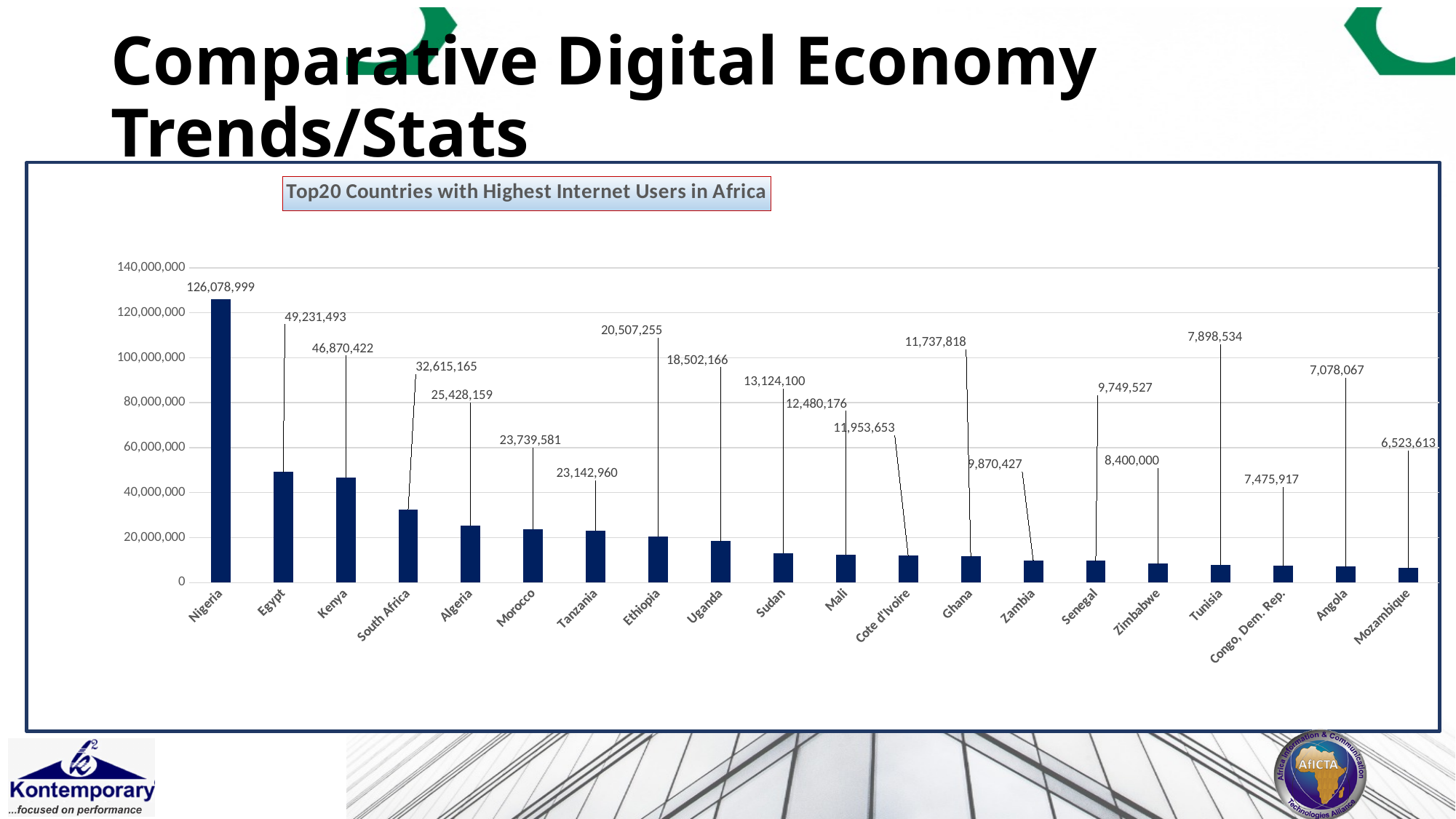
Which country has the highest number of internet users? Nigeria Which country has the lowest number of internet users in the chart? Mozambique How many countries are shown in the chart? 20 What is the value shown for Ghana? 11,737,818 Is the value for Egypt greater or less than 40,000,000? greater Which has more internet users, Morocco or Tanzania? Morocco What is the number of internet users for South Africa? 32,615,165 What kind of chart is shown on the slide? Bar chart What is the number of internet users for Nigeria? 126,078,999 Do the values generally rise or fall from left to right across the countries? Fall What is the difference between the values for Egypt and Kenya? 2,361,071 What is the title of the chart? Top20 Countries with Highest Internet Users in Africa